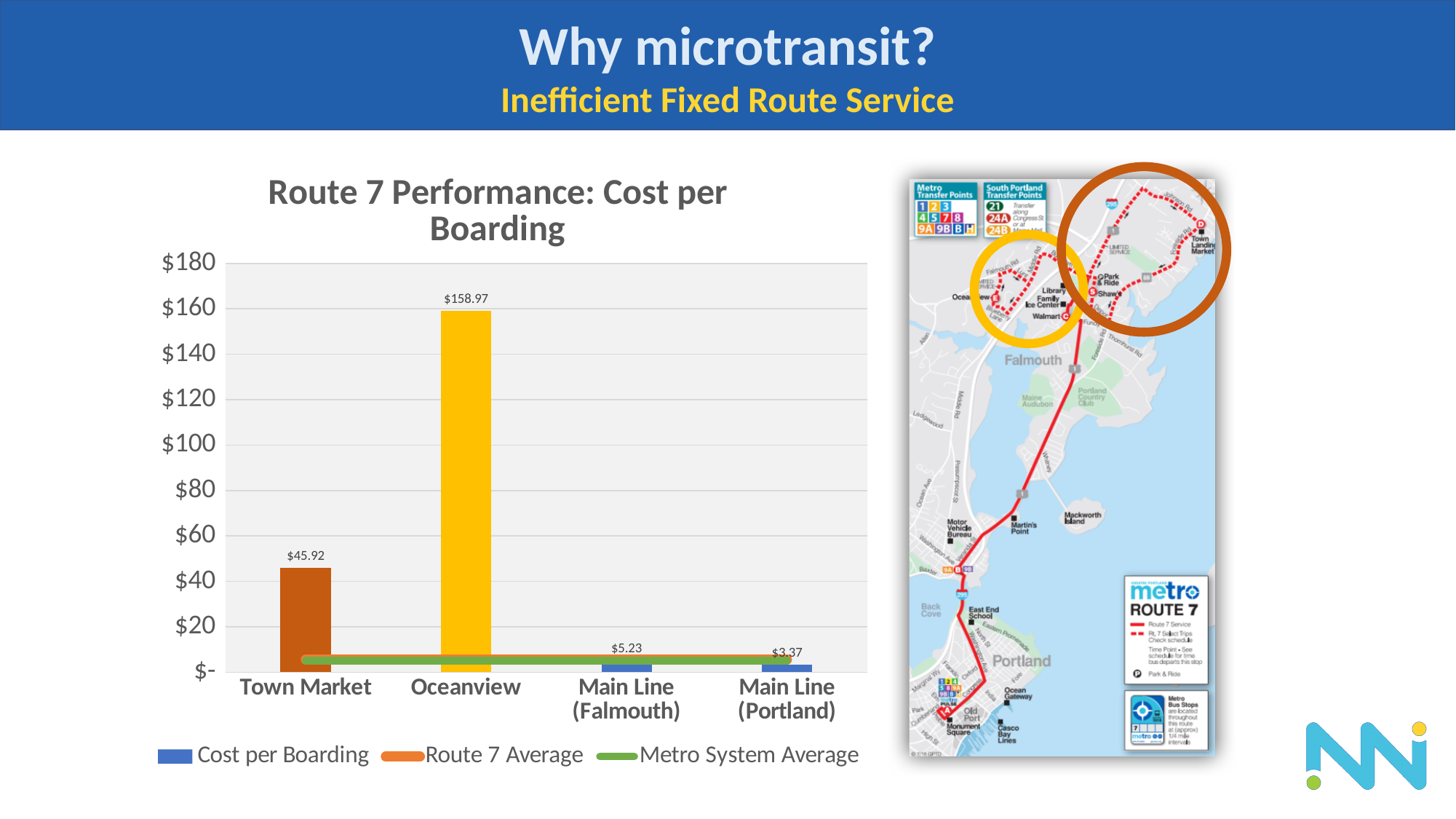
How many series does the chart legend list? 3 What is the cost per boarding for Town Market? $45.92 Which has a higher cost per boarding, Town Market or Main Line (Falmouth)? Town Market Is the cost per boarding for Oceanview greater or less than $140? greater How many segments are shown on the x axis of the chart? 4 What is the title of the chart? Route 7 Performance: Cost per Boarding What is the cost per boarding for Main Line (Portland)? $3.37 Which segment has the lowest cost per boarding? Main Line (Portland) How much higher is the cost per boarding for Oceanview than for Town Market? $113.05 What is the cost per boarding for Oceanview? $158.97 Which segment has the highest cost per boarding? Oceanview What is the cost per boarding for Main Line (Falmouth)? $5.23